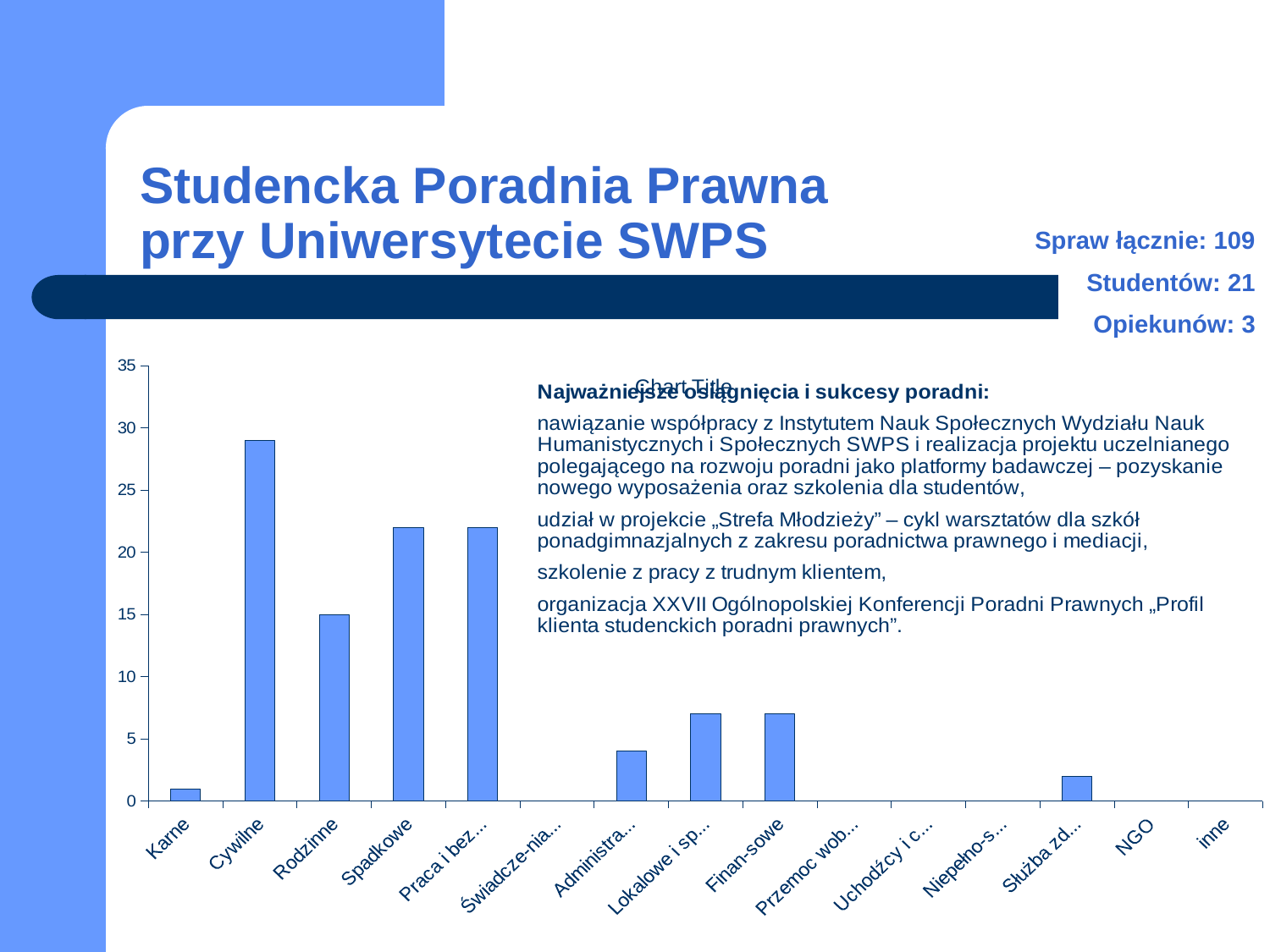
Is the value for Cywilne greater or less than 25? greater Which category has the highest bar in the chart? Cywilne What is the title shown on the chart? Chart Title What kind of chart is shown on the slide? bar chart Is the value for Spadkowe greater or less than 20? greater Is the value for Karne greater or less than 5? less What is the value for Rodzinne in the chart? 15 Which is larger, the value for Cywilne or the value for Rodzinne? Cywilne How many categories are shown on the x axis of the chart? 15 Which is larger, the value for Finan-sowe or the value for Służba zd...? Finan-sowe